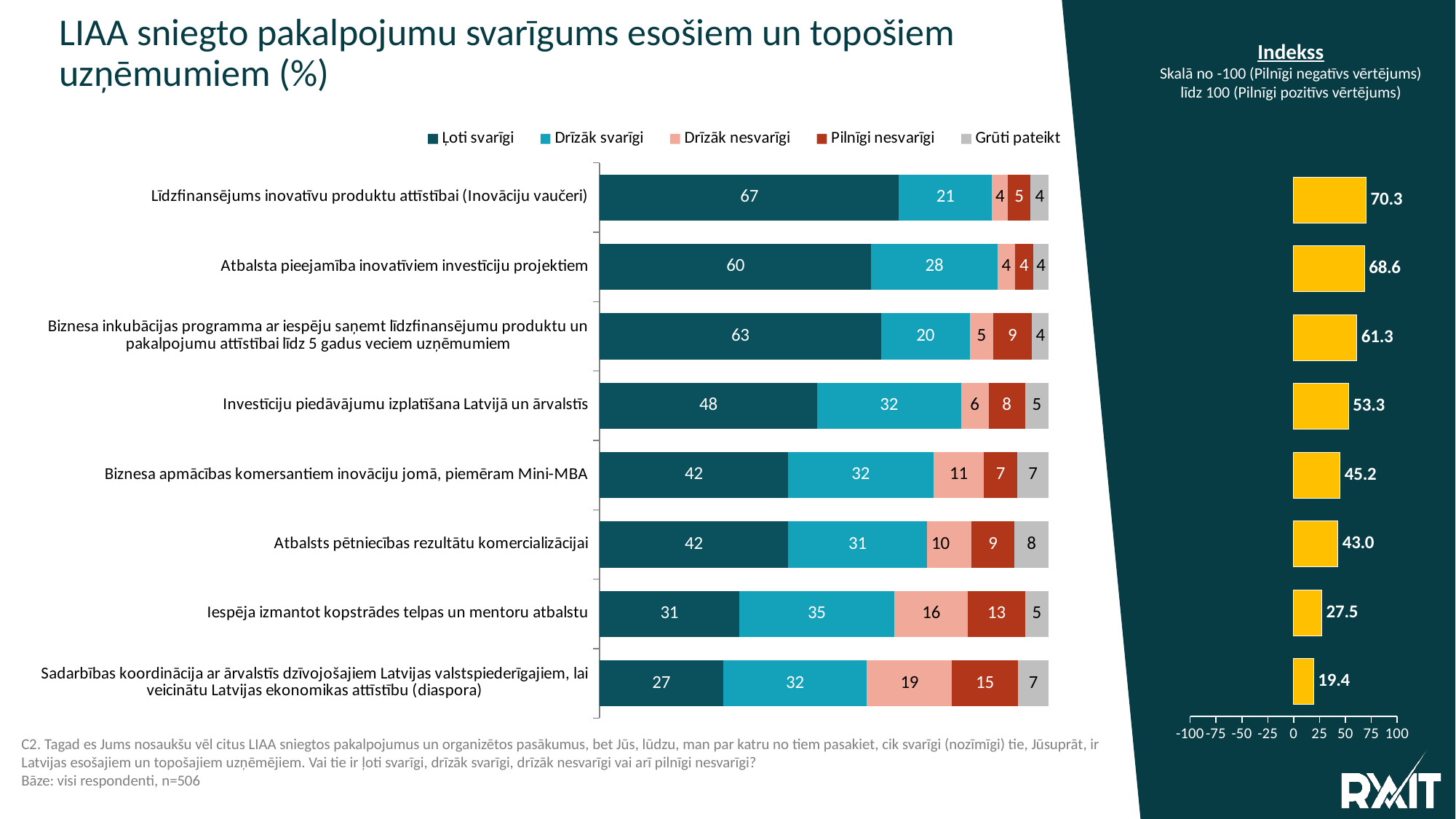
How many series does the legend of the stacked bar chart on the left list? 5 In the 'Indekss' chart on the right, which service has the highest index value? Līdzfinansējums inovatīvu produktu attīstībai (Inovāciju vaučeri) How many services (categories) are shown in the stacked bar chart on the left? 8 In the stacked bar chart on the left, what percentage rated 'Investīciju piedāvājumu izplatīšana Latvijā un ārvalstīs' as 'Ļoti svarīgi'? 48 In the stacked bar chart on the left, what is the difference in the 'Ļoti svarīgi' share between 'Līdzfinansējums inovatīvu produktu attīstībai (Inovāciju vaučeri)' and 'Atbalsta pieejamība inovatīviem investīciju projektiem'? 7 In the 'Indekss' chart on the right, what is the index value for 'Biznesa apmācības komersantiem inovāciju jomā, piemēram Mini-MBA'? 45.2 In the stacked bar chart on the left, what percentage rated the 'diaspora' cooperation coordination service as 'Pilnīgi nesvarīgi'? 15 In the 'Indekss' chart on the right, which service has the lowest index value? Sadarbības koordinācija ar ārvalstīs dzīvojošajiem Latvijas valstspiederīgajiem, lai veicinātu Latvijas ekonomikas attīstību (diaspora) What kind of chart is the chart on the left? Stacked bar chart In the stacked bar chart on the left, what is the total of all segments for 'Atbalsts pētniecības rezultātu komercializācijai'? 100 According to the 'Indekss' chart on the right, what is the range of the index scale? -100 to 100 In the stacked bar chart on the left, which has a larger 'Drīzāk svarīgi' share: 'Iespēja izmantot kopstrādes telpas un mentoru atbalstu' or 'Investīciju piedāvājumu izplatīšana Latvijā un ārvalstīs'? Iespēja izmantot kopstrādes telpas un mentoru atbalstu